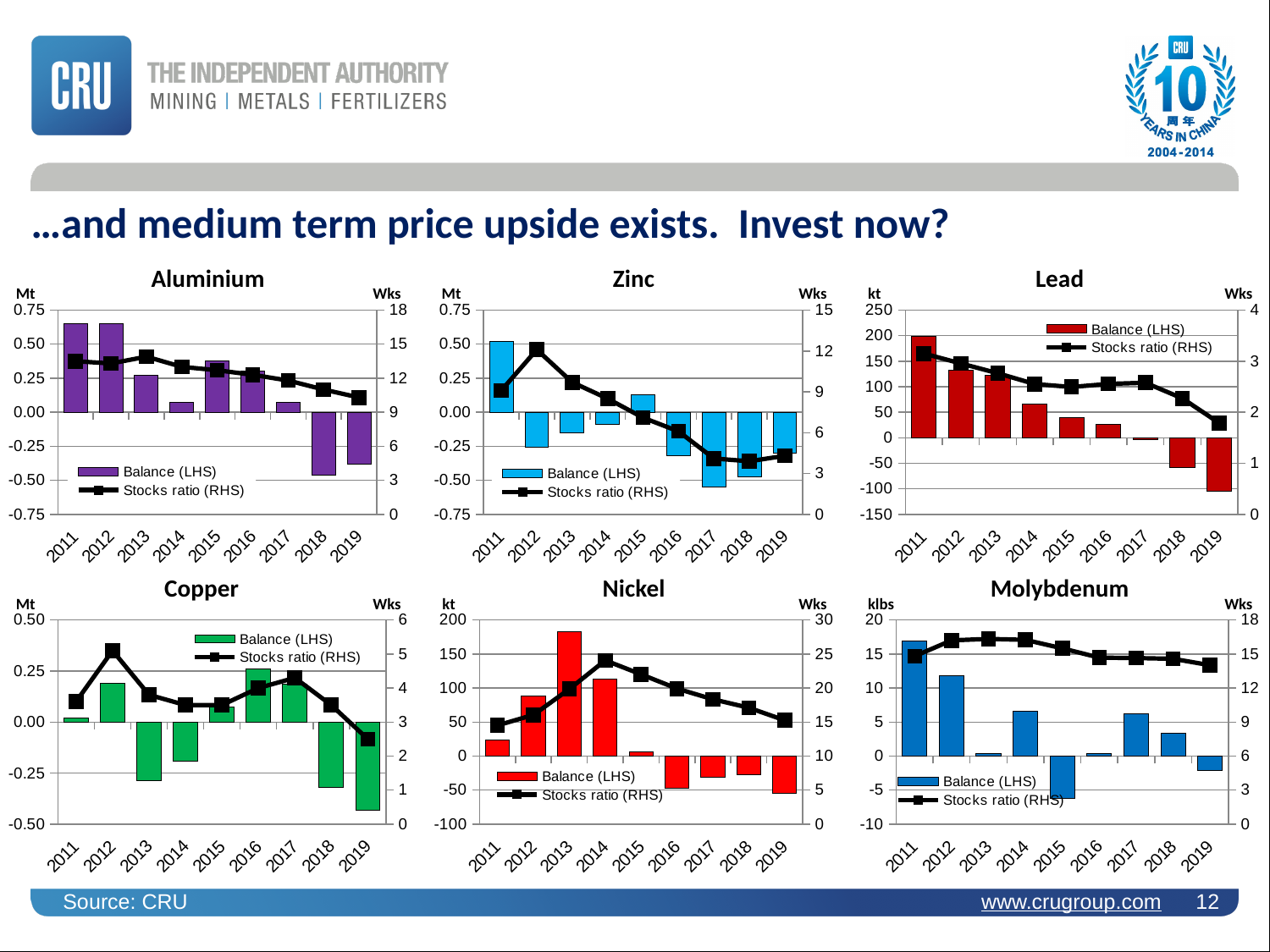
In the Lead chart, which year has the highest Balance (LHS) bar? 2011 In the Nickel chart, which year has the larger Balance (LHS) bar, 2013 or 2014? 2013 How many series does the legend of the Copper chart list? 2 How many years are shown on the x axis of the Zinc chart? 9 In the Lead chart, is the Stocks ratio (RHS) value for 2019 greater or less than 2? less In the Nickel chart, is the Balance (LHS) value for 2013 greater or less than 150? greater In the Copper chart, which year has the highest Balance (LHS) bar? 2016 In the Zinc chart, is the Balance (LHS) value for 2017 greater or less than -0.25? less In the Aluminium chart, which year has the larger Balance (LHS) bar, 2013 or 2015? 2015 In the Nickel chart, which year has the lowest Balance (LHS) bar? 2019 In the Lead chart, does the Stocks ratio (RHS) line generally rise or fall from 2011 to 2019? fall In the Molybdenum chart, which year has the lowest Balance (LHS) bar? 2015